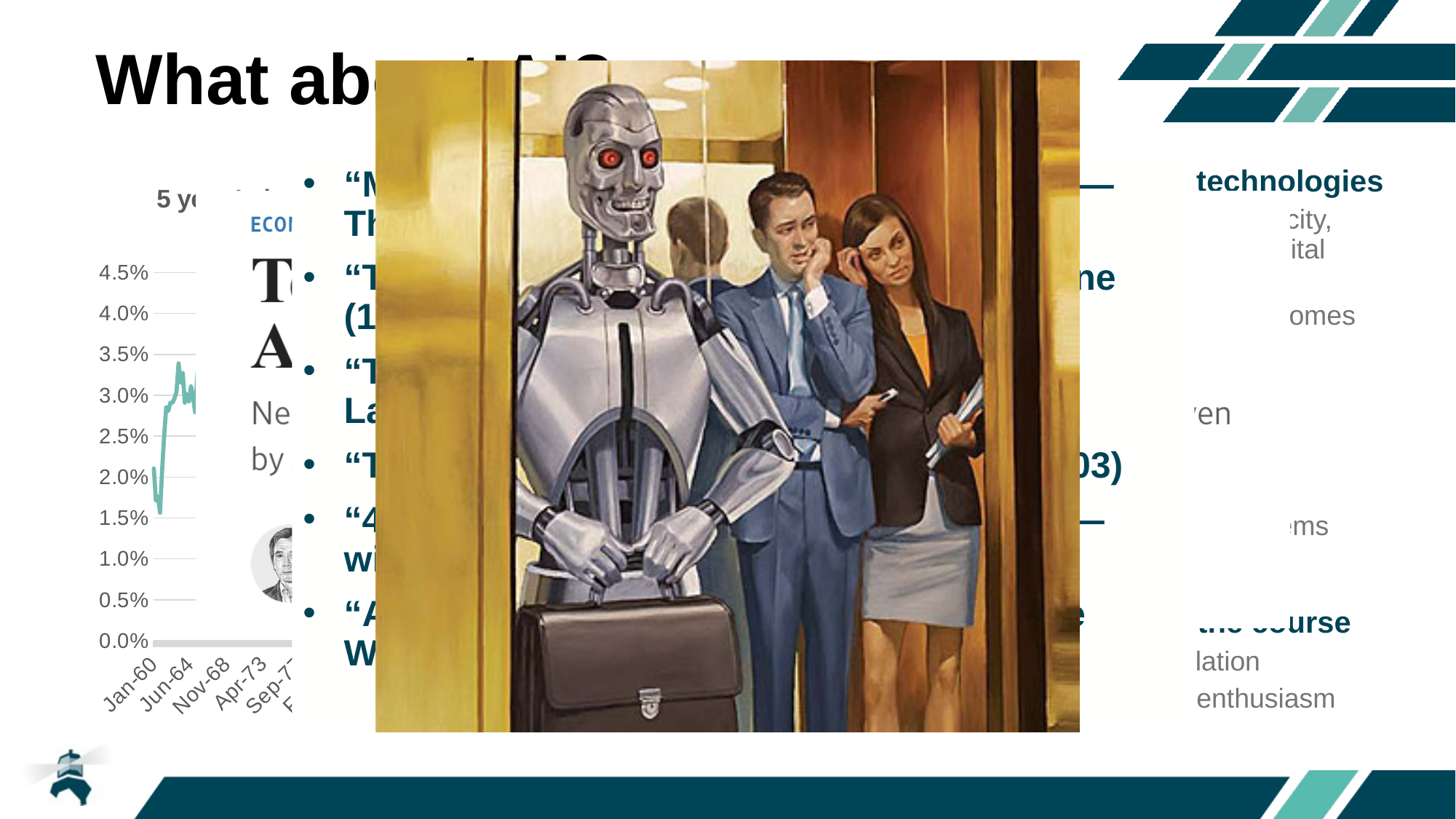
Does the line in the chart on the left rise or fall between Jan-60 and Jun-64? rise What is the highest tick shown on the y axis of the chart on the left? 4.5% What is the first label on the x axis of the chart on the left? Jan-60 What kind of chart is shown on the left of the slide? line chart In the chart on the left, is the highest visible value of the line (around Jun-64) greater or less than 3.0%? greater